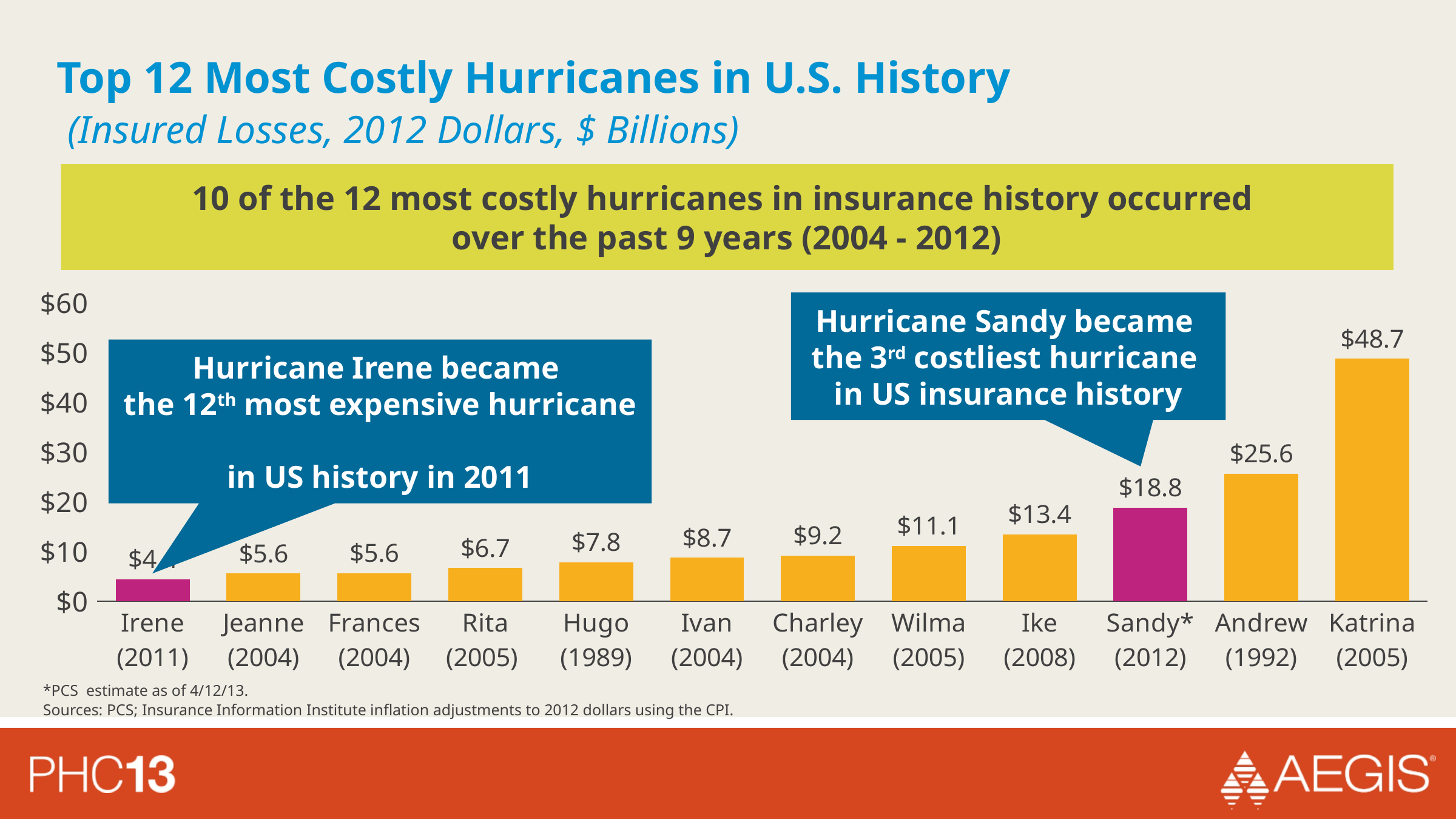
What kind of chart is shown on the slide? Bar chart What is the insured loss value shown for Katrina (2005)? $48.7 What is the insured loss value shown for Sandy* (2012)? $18.8 What is the difference between the values for Katrina (2005) and Andrew (1992)? $23.1 Which has a larger value, Wilma (2005) or Hugo (1989)? Wilma (2005) Is the value for Sandy* (2012) greater or less than $20? less How many hurricanes are shown on the chart? 12 Do the values generally rise or fall moving from left to right along the x axis? Rise Which hurricane has the highest insured loss on the chart? Katrina (2005) What is the insured loss value shown for Andrew (1992)? $25.6 What is the insured loss value shown for Ike (2008)? $13.4 Which hurricane has the lowest insured loss on the chart? Irene (2011)